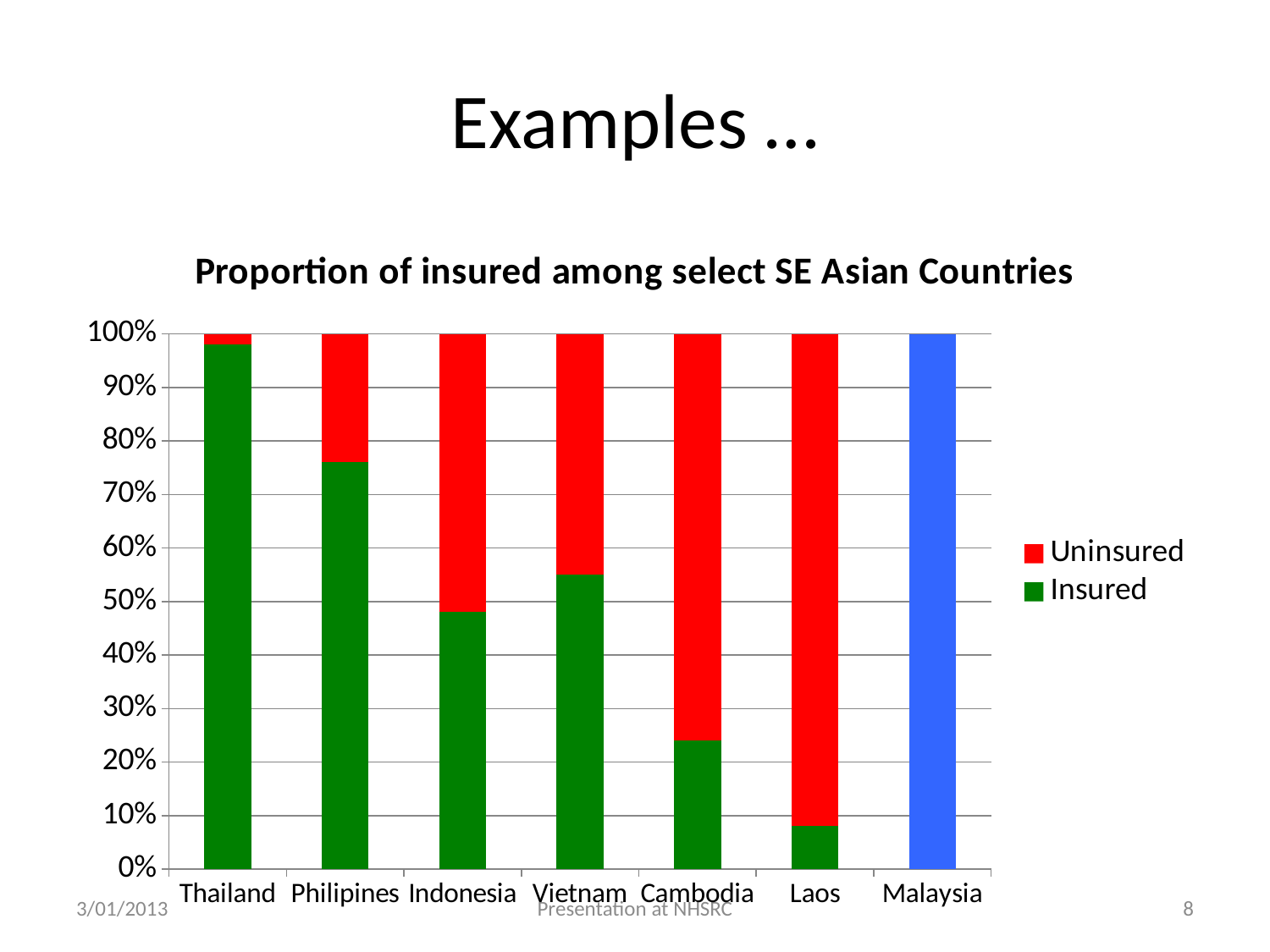
Which country has the lowest Insured proportion among those with a green Insured segment? Laos How many countries are shown on the x axis? 7 How many series does the legend list? 2 What kind of chart is shown on the slide? Stacked bar chart Is the Insured value for Thailand greater or less than 90%? greater Which colour represents the Uninsured series in the legend? Red What is the title of the chart? Proportion of insured among select SE Asian Countries Is the Insured value for Indonesia greater or less than 50%? less Is the Insured value for Laos greater or less than 10%? less Which has the larger Insured proportion, Philipines or Indonesia? Philipines